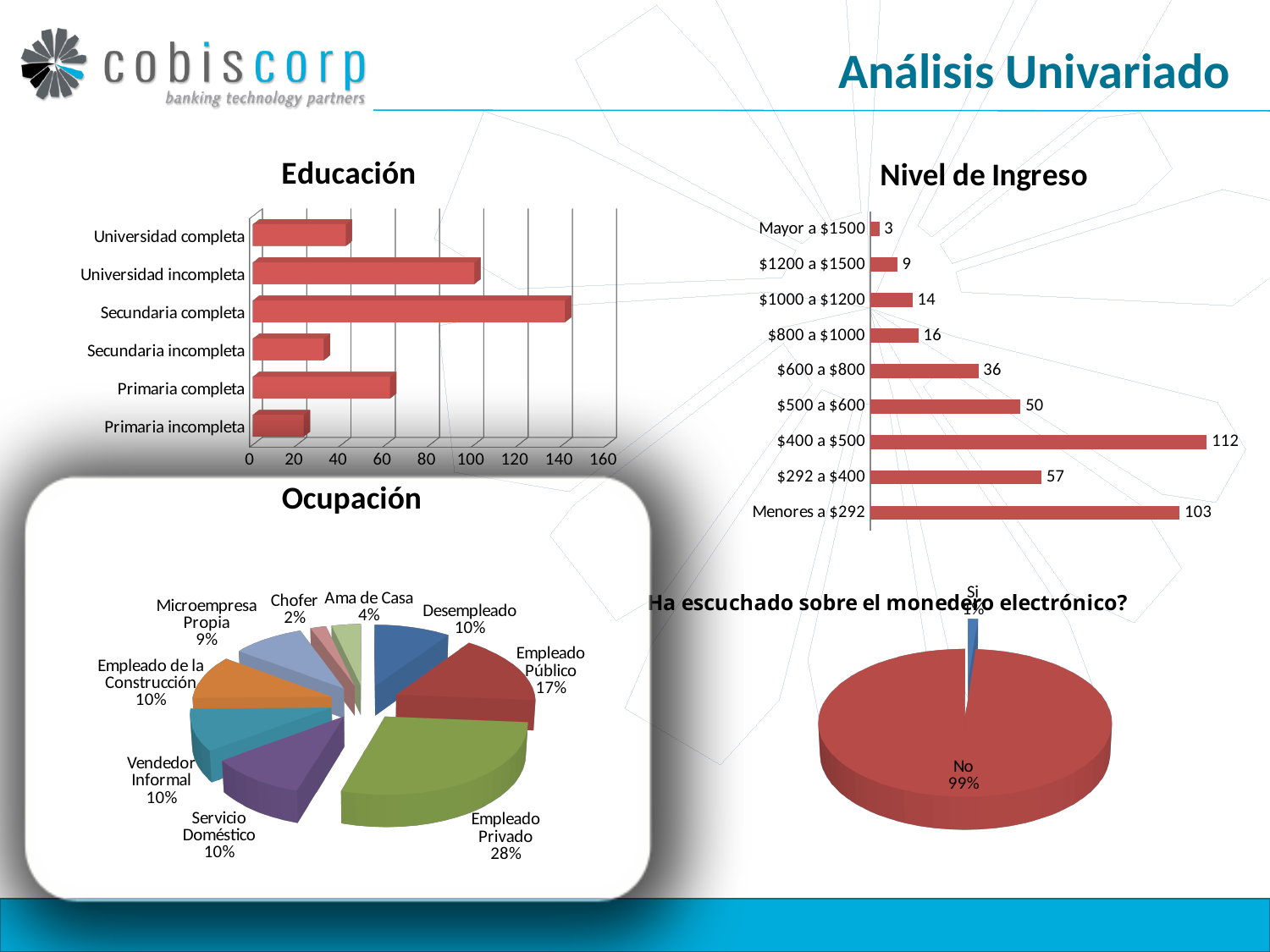
In the Nivel de Ingreso chart, which category has the lowest value? Mayor a $1500 In the Ocupación chart, which category has the smallest share? Chofer In the Educación chart, is the value for Universidad incompleta greater or less than 80? greater In the Ocupación chart, what share does Empleado Privado have? 28% In the Nivel de Ingreso chart, how many income categories are shown? 9 In the Educación chart, which category has the highest value? Secundaria completa In the Nivel de Ingreso chart, what is the value for Menores a $292? 103 In the chart titled 'Ha escuchado sobre el monedero electrónico?', what share answered No? 99% In the Educación chart, is the value for Primaria incompleta greater or less than 40? less In the Nivel de Ingreso chart, what is the difference between $400 a $500 and $292 a $400? 55 What kind of chart is the Educación chart? bar chart In the Nivel de Ingreso chart, what is the value for $400 a $500? 112